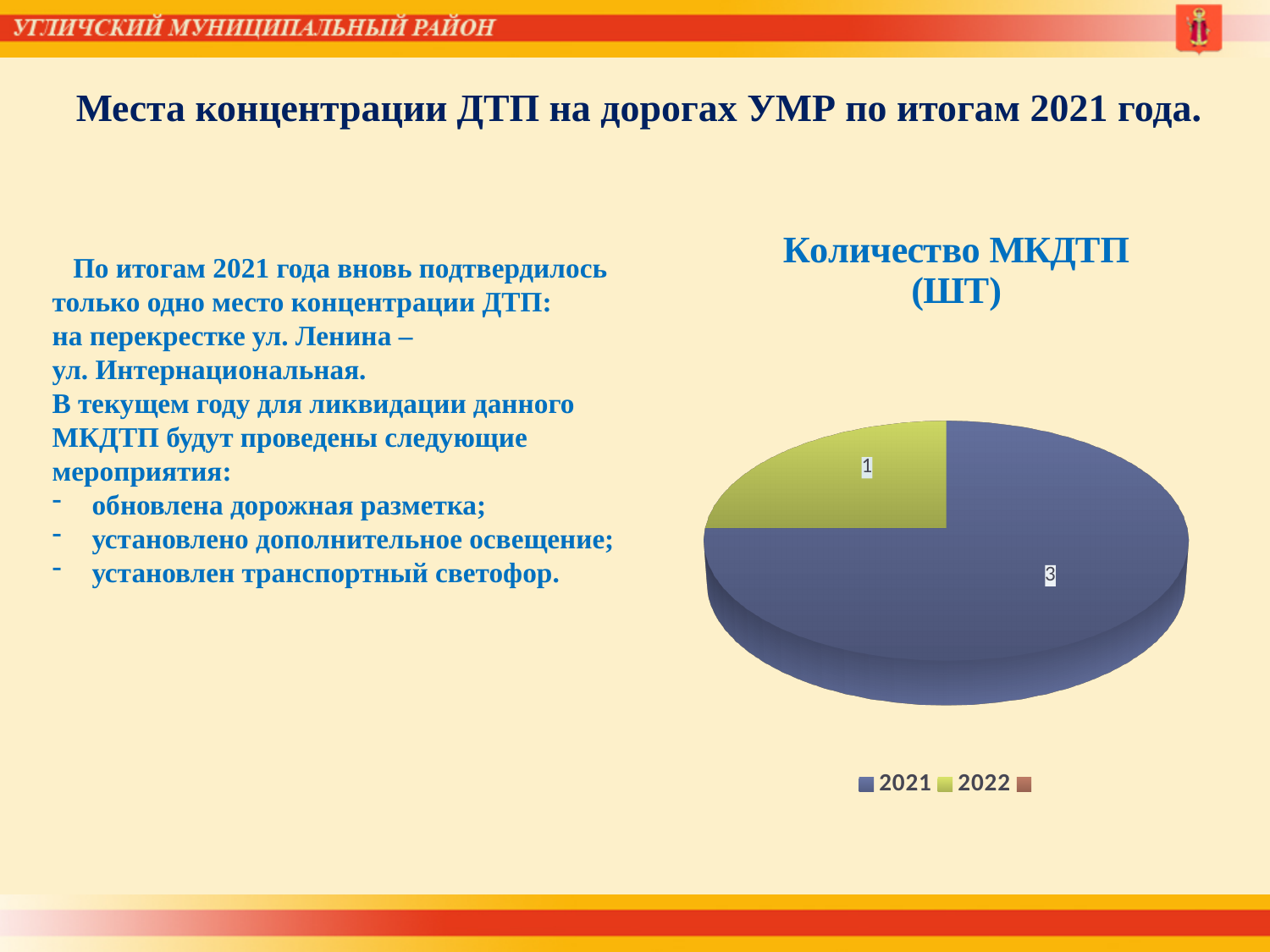
What is the difference between the values for 2021 and 2022 in the pie chart? 2 What is the value for 2022 in the pie chart? 1 Which is larger in the pie chart, the value for 2021 or the value for 2022? 2021 What is the total of the values shown in the pie chart? 4 How many slices does the pie chart show? 2 What colour is the 2022 slice in the pie chart? green What is the value for 2021 in the pie chart? 3 What share of the pie chart does the 2021 slice represent? 75% Which year has the smallest slice in the pie chart? 2022 Which year has the largest slice in the pie chart? 2021 What kind of chart is shown on the slide? pie chart What is the title of the pie chart? Количество МКДТП (ШТ)